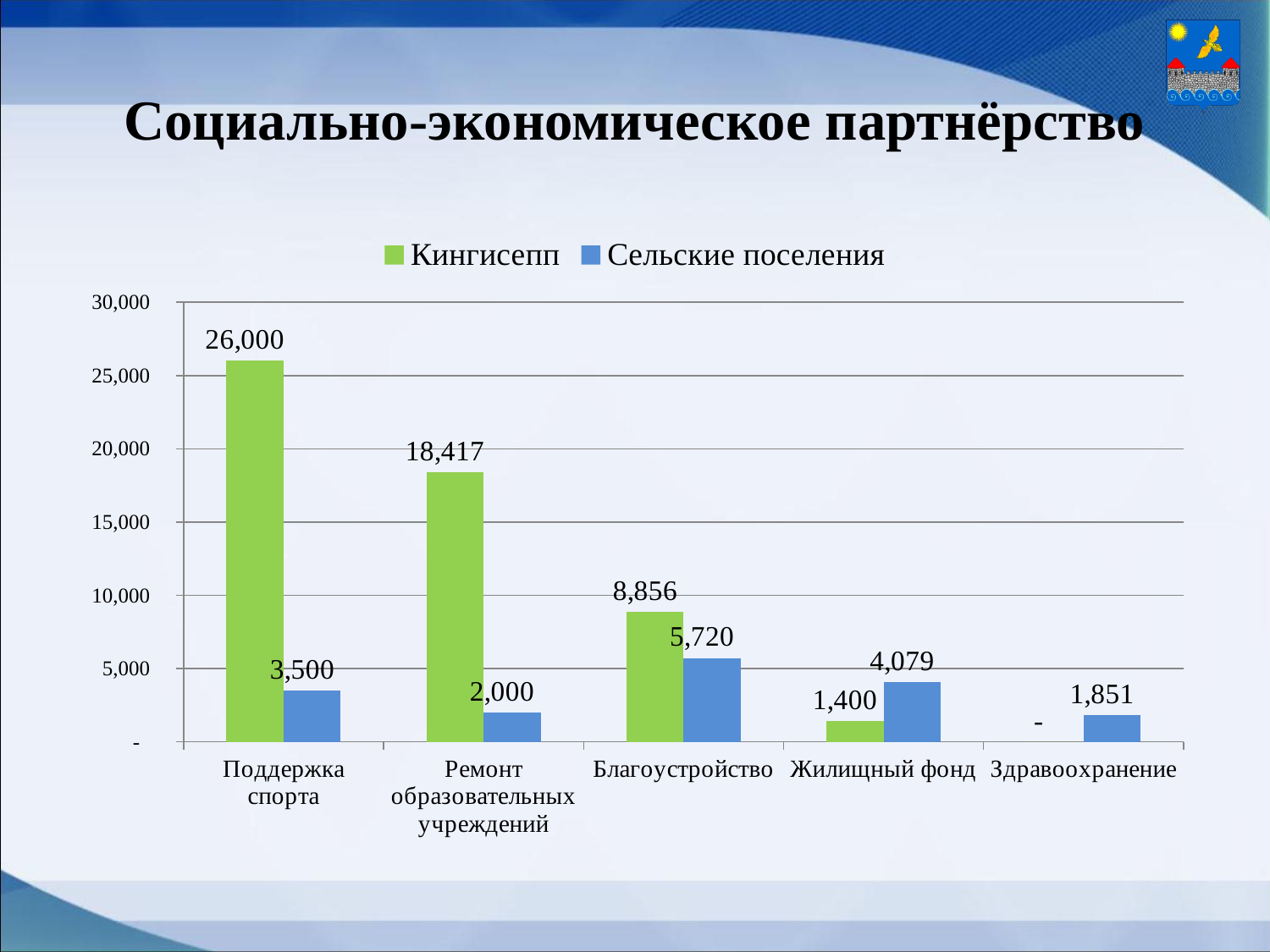
What is the value for Кингисепп in the Ремонт образовательных учреждений category? 18,417 Which category has the highest value for Кингисепп? Поддержка спорта What is the value for Кингисепп in the Поддержка спорта category? 26,000 How many categories are shown on the x axis? 5 Which category has the lowest value for Сельские поселения? Здравоохранение What is the value for Сельские поселения in the Жилищный фонд category? 4,079 Which colour represents the Кингисепп series in the chart? Green What is the difference between the Кингисепп and Сельские поселения values in the Благоустройство category? 3,136 What is the value for Сельские поселения in the Благоустройство category? 5,720 How many series does the legend list? 2 In the Жилищный фонд category, which series has the larger value, Кингисепп or Сельские поселения? Сельские поселения What kind of chart is shown on the slide? Bar chart